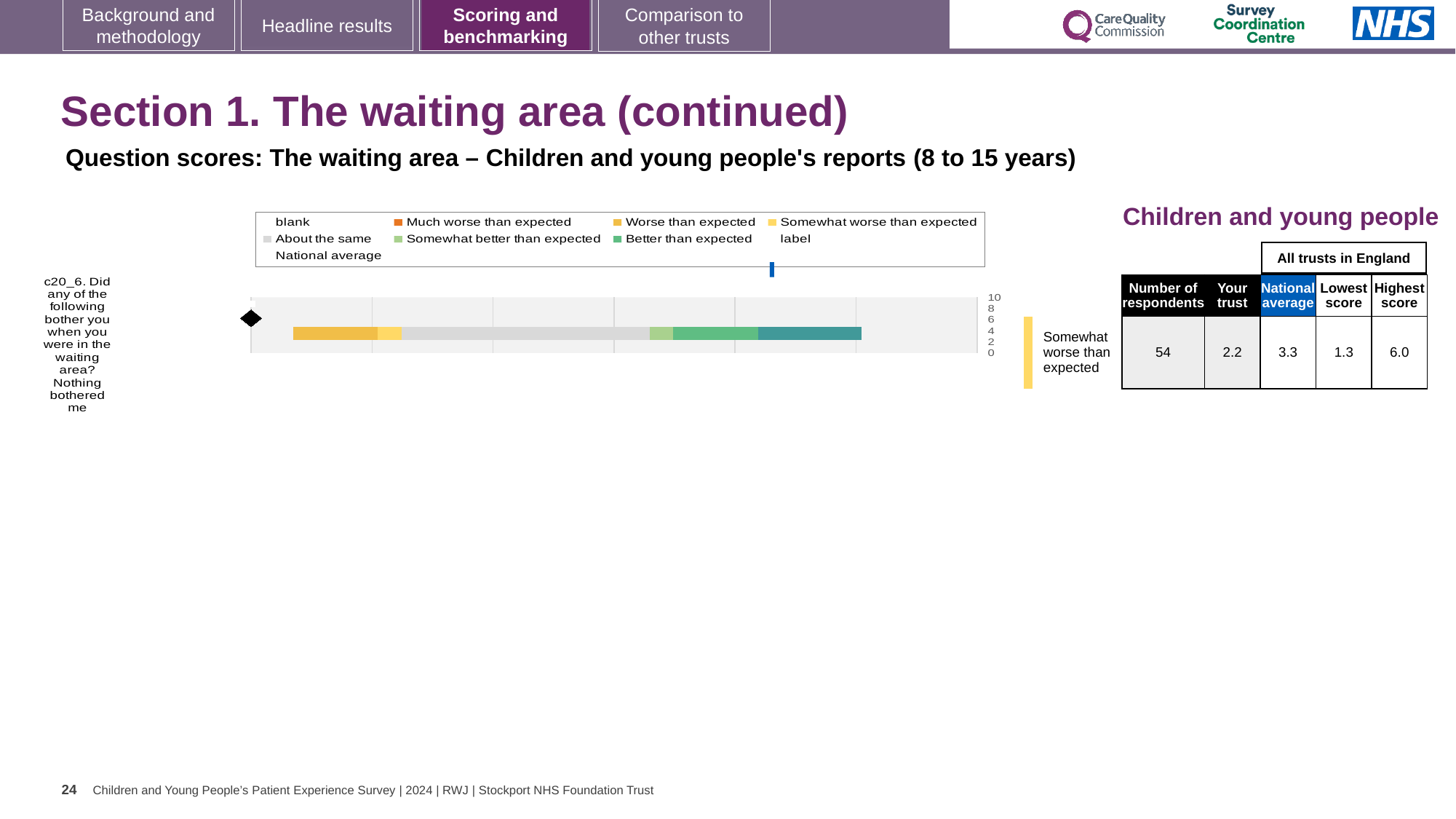
How many respondents are shown for question c20_6 in the table beside the chart? 54 Which is larger for question c20_6, the 'Your trust' score or the national average? National average What is the difference between the highest score and the lowest score for question c20_6 in the table beside the chart? 4.7 How many question categories are plotted in the chart? 1 Which legend entry is shown in grey? About the same What is the national average score for question c20_6 shown in the table beside the chart? 3.3 What is the difference between the national average and the 'Your trust' score for question c20_6? 1.1 What kind of chart is shown on the slide? bar chart How many entries does the chart legend list? 9 What benchmark rating is shown next to the bar for question c20_6? Somewhat worse than expected What is the 'Your trust' score for question c20_6 shown in the table beside the chart? 2.2 Which legend entry is shown in dark orange? Much worse than expected